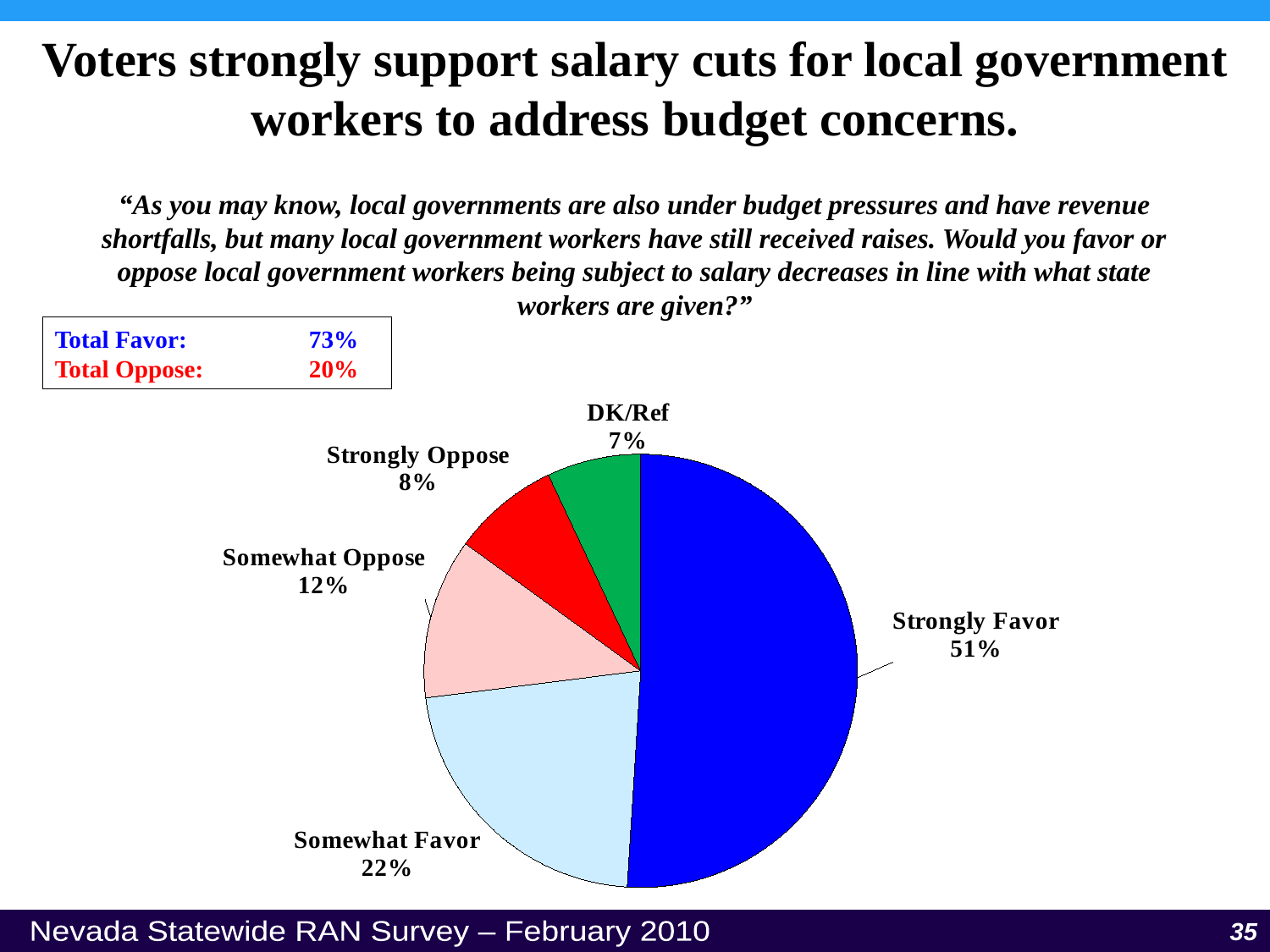
What percentage of voters Strongly Favor salary decreases for local government workers? 51% What kind of chart is shown on the slide? pie chart Which slice of the pie is the smallest? DK/Ref What share of the pie do Strongly Oppose and Somewhat Oppose make up together? 20% What colour is the Strongly Favor slice? blue Which slice of the pie is the largest? Strongly Favor What is the value for DK/Ref? 7% What is the value for Somewhat Favor? 22% What is the difference between Strongly Favor and Somewhat Favor? 29 percentage points Which is larger, Somewhat Oppose or Strongly Oppose? Somewhat Oppose What is the value for Somewhat Oppose? 12% How many slices does the pie chart have? 5